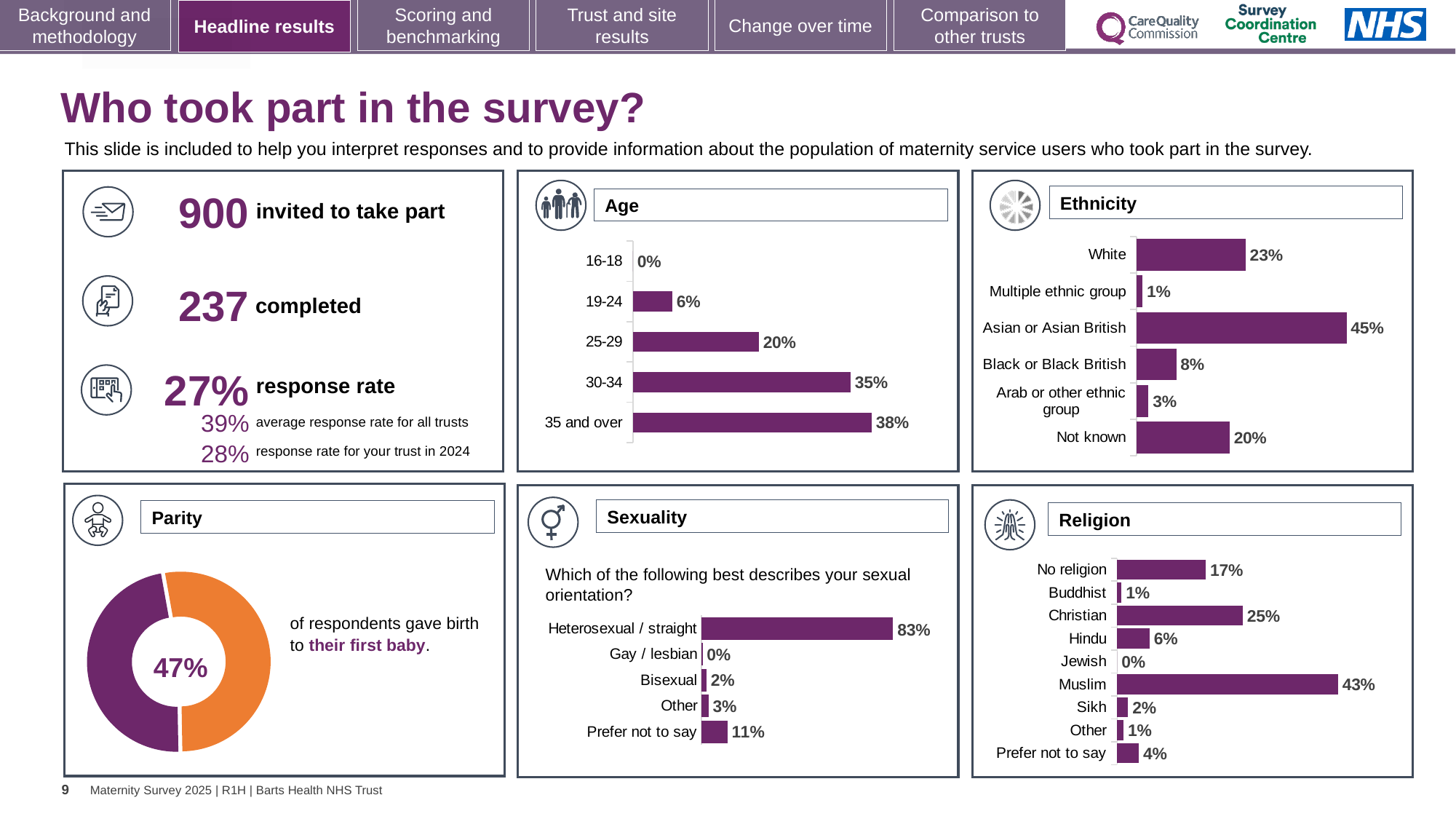
In the Sexuality chart, which is larger, Bisexual or Other? Other In the Ethnicity chart, what is the value for Asian or Asian British? 45% What type of chart is used in the Parity panel? Doughnut chart In the Age chart, which age group has the highest percentage? 35 and over In the Age chart, what percentage of respondents were aged 30-34? 35% In the Sexuality chart, what percentage of respondents answered Prefer not to say? 11% In the Religion chart, what is the value for Christian? 25% In the Ethnicity chart, which category has the lowest percentage? Multiple ethnic group In the Ethnicity chart, what is the difference between White and Black or Black British? 15% In the Religion chart, how many categories are shown? 9 In the Religion chart, which religion has the highest percentage? Muslim In the Parity chart, what percentage of respondents gave birth to their first baby? 47%